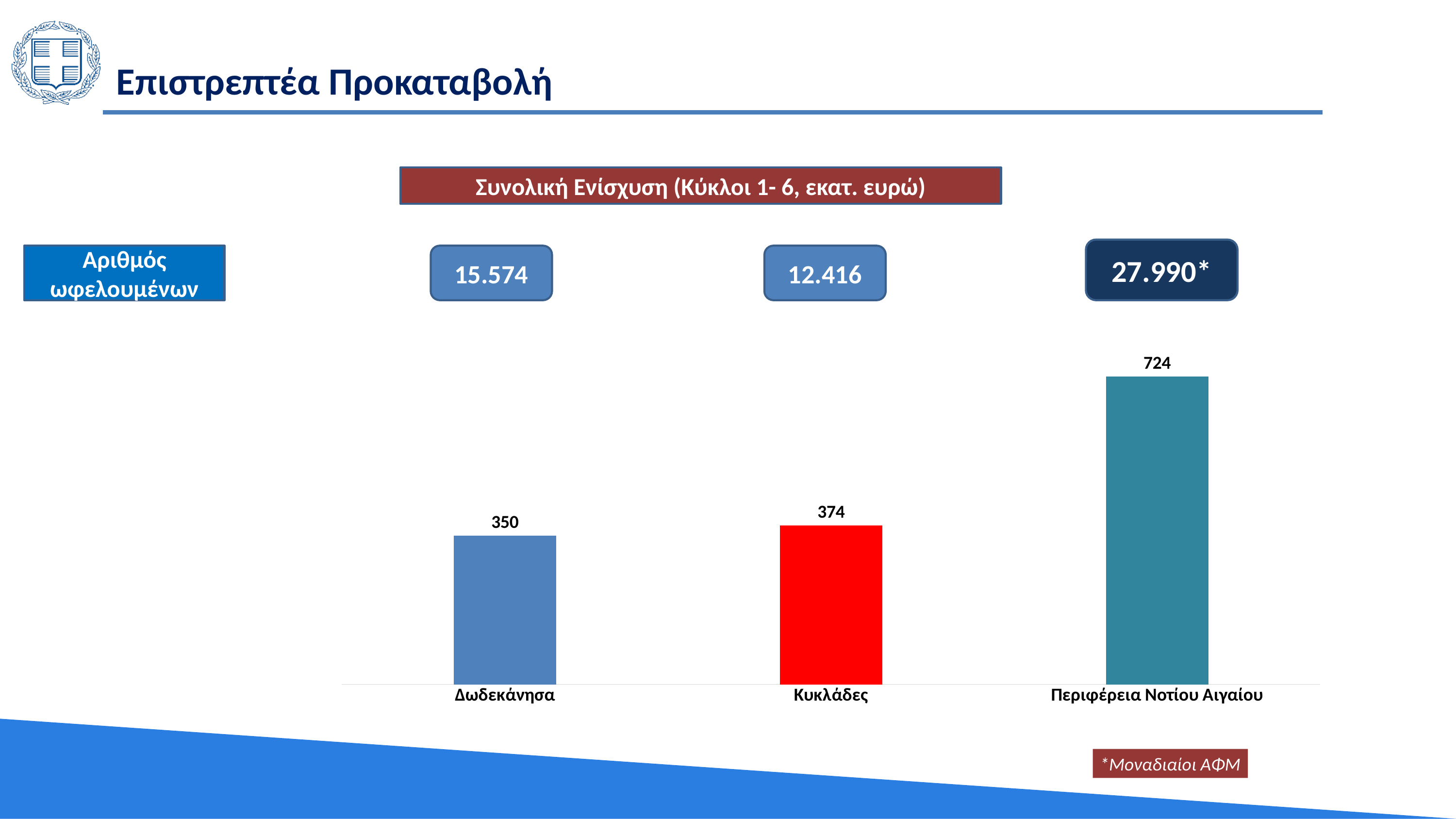
What is the value for Δωδεκάνησα in the chart? 350 What colour is the bar for Κυκλάδες? red Which is larger, the value for Κυκλάδες or the value for Δωδεκάνησα? Κυκλάδες What is the difference between the values for Κυκλάδες and Δωδεκάνησα? 24 What is the value for Κυκλάδες in the chart? 374 What is the title shown above the chart? Συνολική Ενίσχυση (Κύκλοι 1- 6, εκατ. ευρώ) How many categories are shown in the chart? 3 Which category has the lowest value in the chart? Δωδεκάνησα What is the value for Περιφέρεια Νοτίου Αιγαίου in the chart? 724 What is the difference between the values for Περιφέρεια Νοτίου Αιγαίου and Κυκλάδες? 350 Which category has the highest value in the chart? Περιφέρεια Νοτίου Αιγαίου What kind of chart is shown on the slide? bar chart